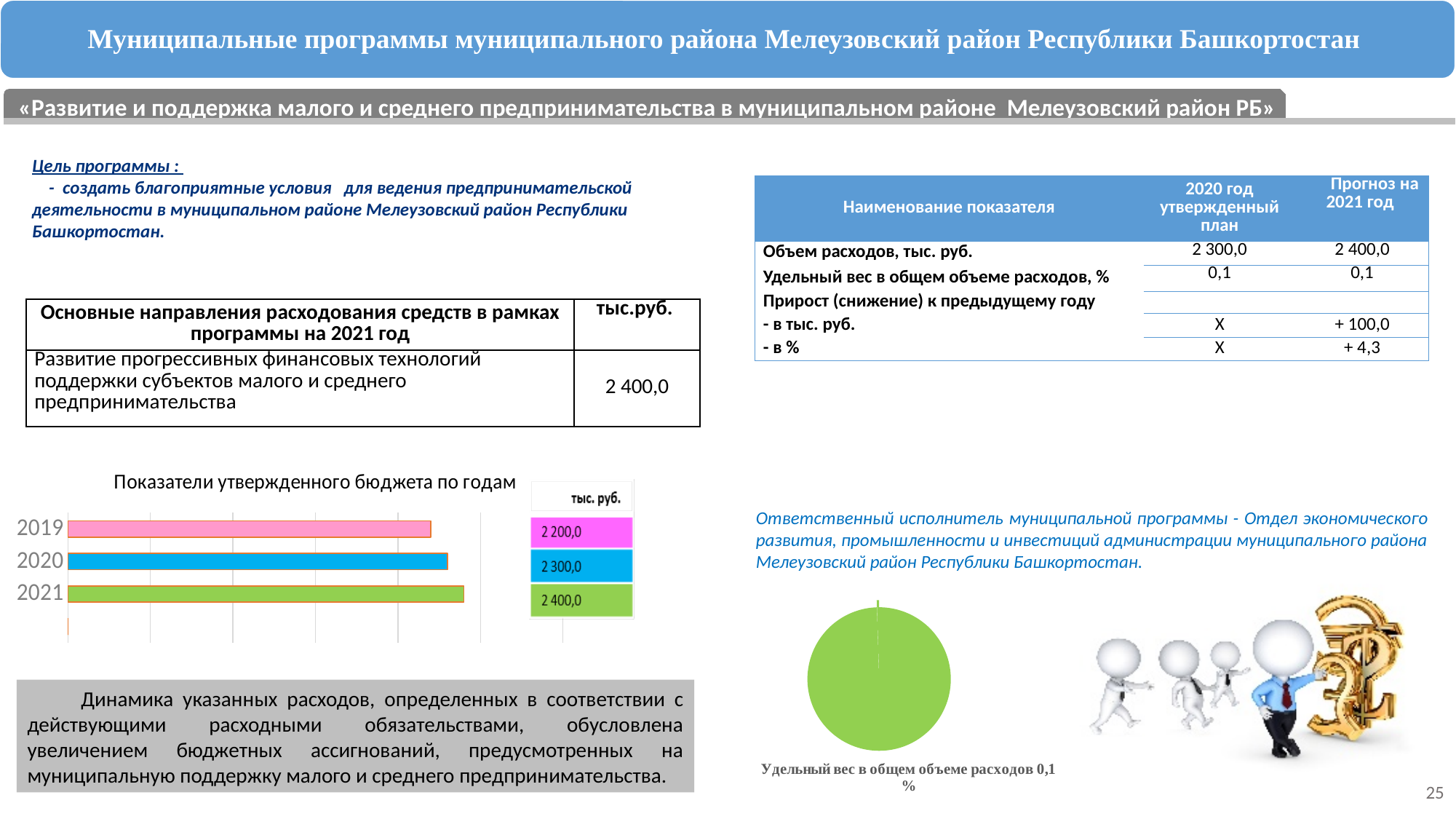
In the bar chart 'Показатели утвержденного бюджета по годам', what is the difference between the 2021 and 2019 values? 200,0 In the bar chart 'Показатели утвержденного бюджета по годам', what is the value for 2021? 2 400,0 What type of chart is shown below the text about the responsible executor, labelled 'Удельный вес в общем объеме расходов 0,1 %'? pie chart In the bar chart 'Показатели утвержденного бюджета по годам', what is the value for 2019? 2 200,0 In the bar chart 'Показатели утвержденного бюджета по годам', do the values rise or fall from 2019 to 2021? rise In the bar chart 'Показатели утвержденного бюджета по годам', which is larger, the value for 2020 or the value for 2021? 2021 In the bar chart 'Показатели утвержденного бюджета по годам', which year has the lowest value? 2019 In the bar chart 'Показатели утвержденного бюджета по годам', what is the difference between the 2020 and 2019 values? 100,0 How many years are shown in the bar chart 'Показатели утвержденного бюджета по годам'? 3 What type of chart is 'Показатели утвержденного бюджета по годам'? bar chart In the bar chart 'Показатели утвержденного бюджета по годам', what is the value for 2020? 2 300,0 In the bar chart 'Показатели утвержденного бюджета по годам', which year has the highest value? 2021